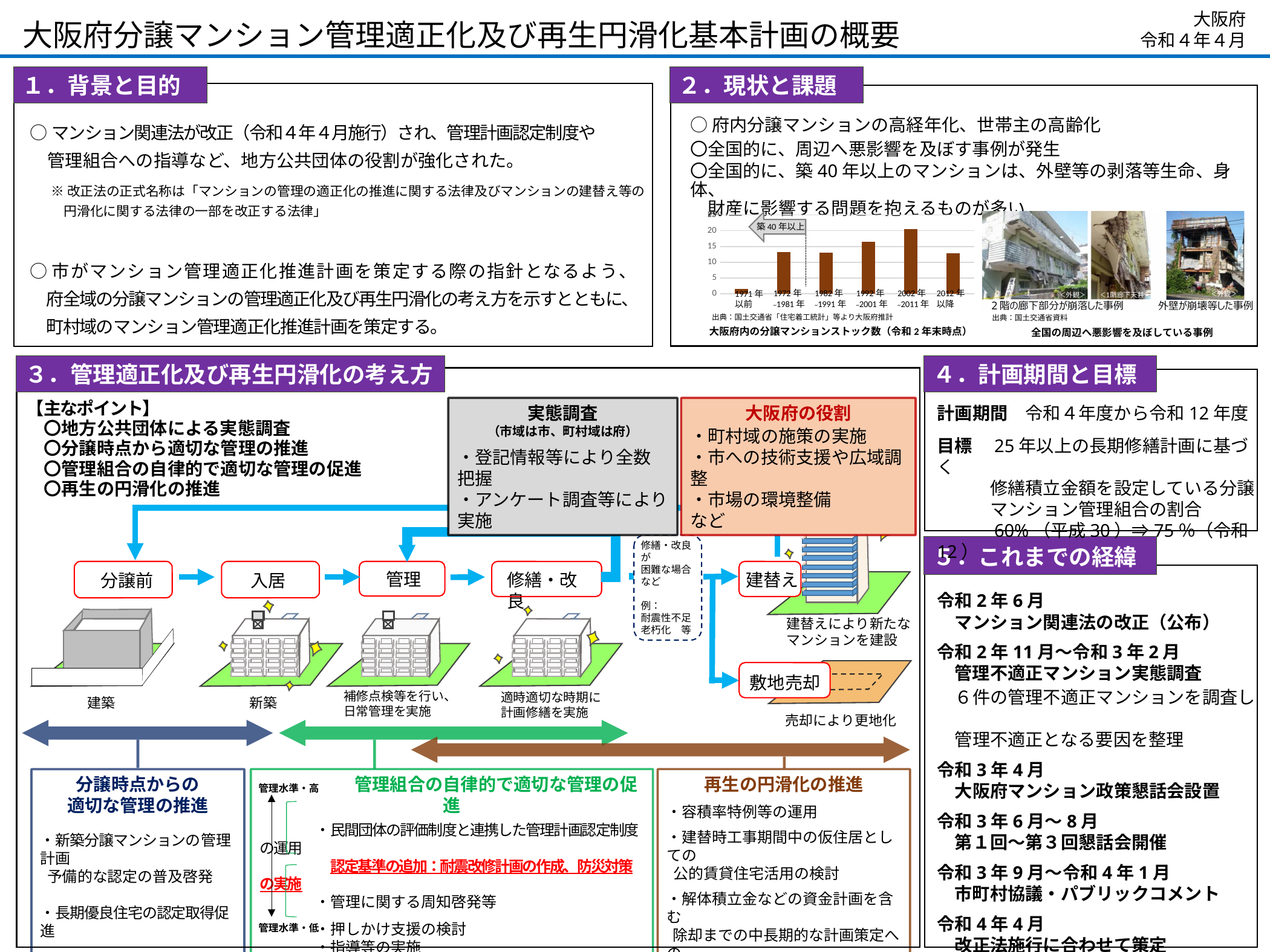
How many construction-period categories are shown in the 大阪府内の分譲マンションストック数 chart? 6 What source is cited below the 大阪府内の分譲マンションストック数 chart? 国土交通省「住宅着工統計」等より大阪府推計 What kind of chart is used to show 大阪府内の分譲マンションストック数（令和2年末時点）? bar chart In the 大阪府内の分譲マンションストック数 chart, do the values rise or fall from 1982年～1991年 to 2002年～2011年? rise In the 大阪府内の分譲マンションストック数 chart, is the value for 2012年以降 greater or less than 15? less In the 大阪府内の分譲マンションストック数 chart, which construction period has the lowest stock? 1971年以前 In the 大阪府内の分譲マンションストック数 chart, is the value for 1972年～1981年 greater or less than 10? greater In the 大阪府内の分譲マンションストック数 chart, which is larger: the value for 1992年～2001年 or the value for 1972年～1981年? 1992年～2001年 In the 大阪府内の分譲マンションストック数 chart, which is larger: the value for 2002年～2011年 or the value for 2012年以降? 2002年～2011年 In the 大阪府内の分譲マンションストック数 chart, is the value for 1971年以前 greater or less than 5? less In the 大阪府内の分譲マンションストック数 chart, which construction period has the highest stock? 2002年～2011年